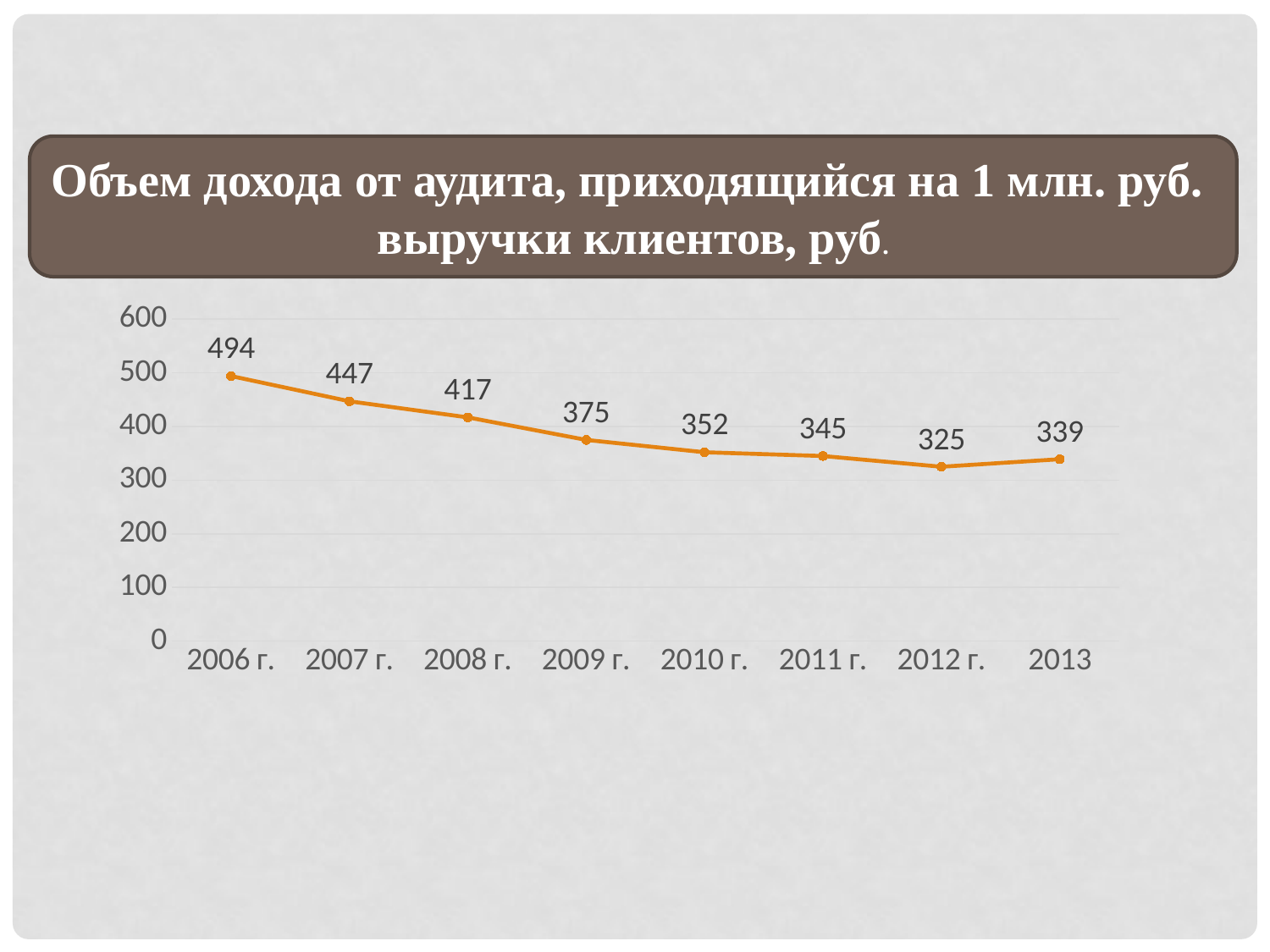
What is the difference between the values for 2012 г. and 2013? 14 Do the values generally rise or fall from 2006 г. to 2012 г.? fall What is the value for 2006 г.? 494 Is the value for 2011 г. greater or less than 400? less What is the value for 2009 г.? 375 Which year has the highest value? 2006 г. Which is larger, the value for 2008 г. or the value for 2010 г.? 2008 г. Which year has the lowest value? 2012 г. What is the value for 2013? 339 How many years are plotted on the chart? 8 What is the difference between the values for 2006 г. and 2007 г.? 47 What kind of chart is shown on the slide? line chart